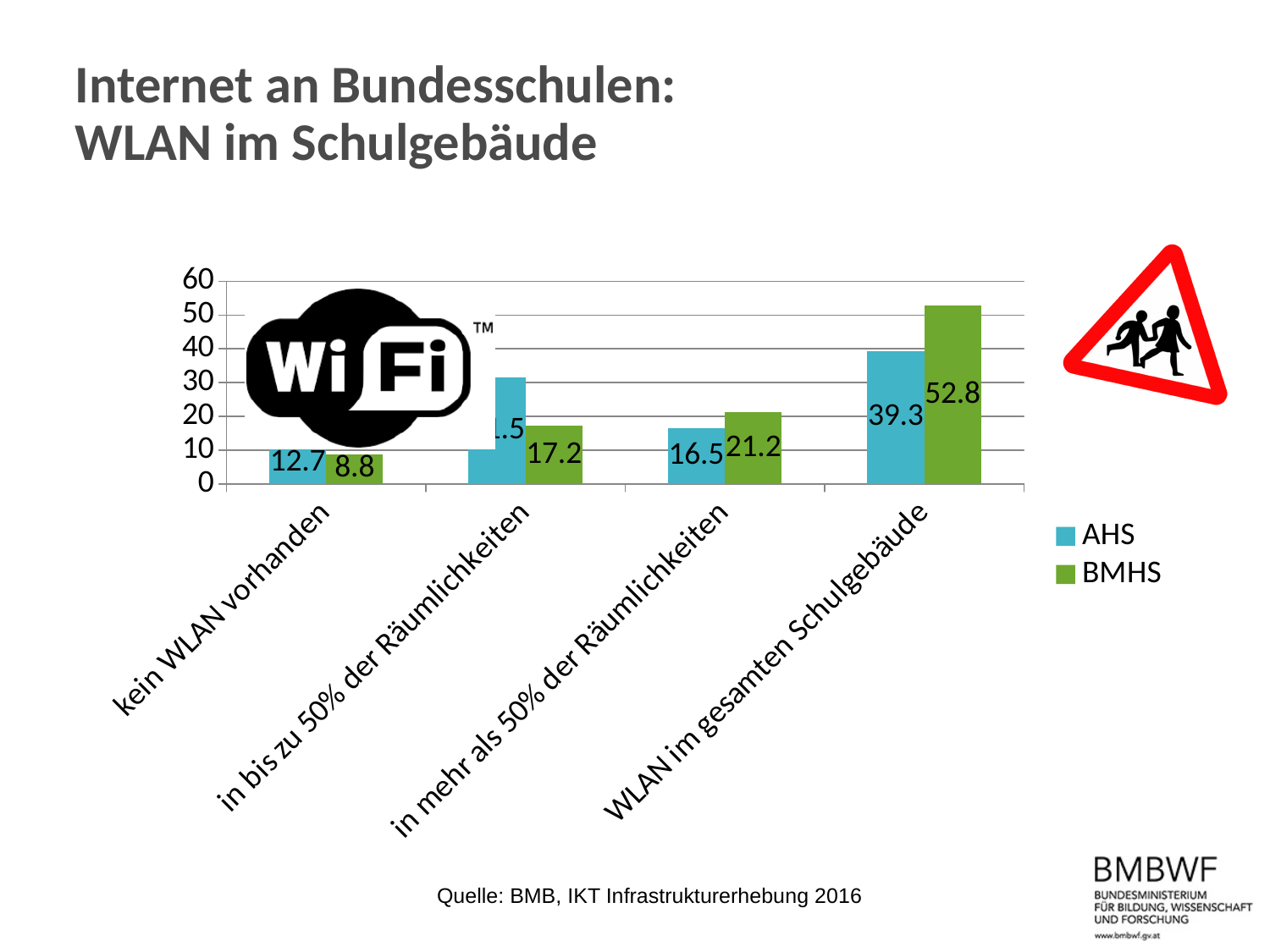
Which category has the highest BMHS value? WLAN im gesamten Schulgebäude Is the AHS value for "in bis zu 50% der Räumlichkeiten" greater or less than 20? greater For "kein WLAN vorhanden", which series has the larger value, AHS or BMHS? AHS How many categories are shown on the x axis of the chart? 4 What is the BMHS value for "in mehr als 50% der Räumlichkeiten"? 21.2 What is the AHS value for "WLAN im gesamten Schulgebäude"? 39.3 How many series does the legend list? 2 Which category has the lowest BMHS value? kein WLAN vorhanden What kind of chart is shown on the slide? bar chart What is the AHS value for "kein WLAN vorhanden"? 12.7 What is the difference between the BMHS and AHS values for "WLAN im gesamten Schulgebäude"? 13.5 What is the BMHS value for "WLAN im gesamten Schulgebäude"? 52.8